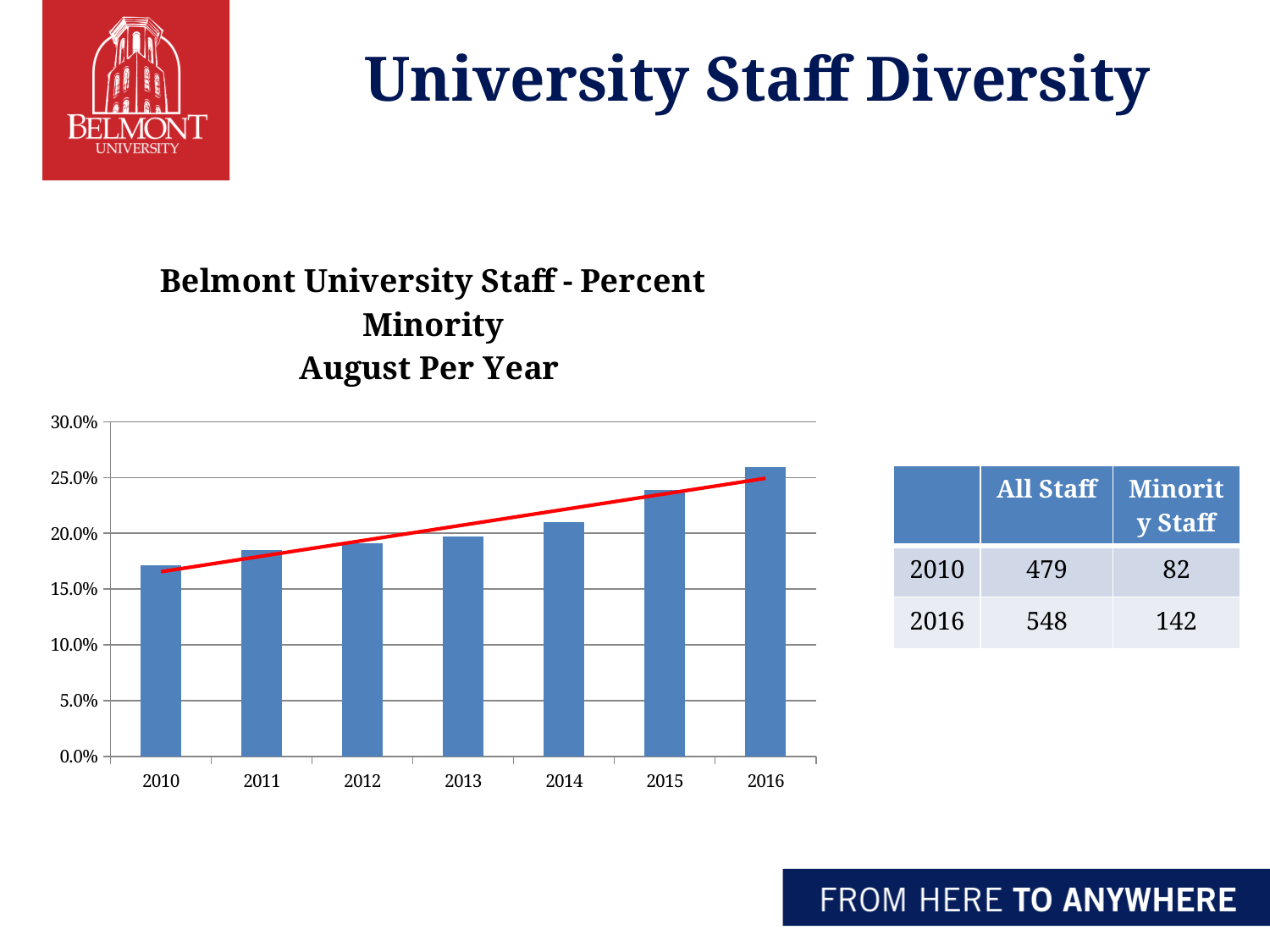
Is the value for 2016 greater or less than 25.0%? greater What kind of chart is shown on the slide? bar chart Is the value for 2011 greater or less than 20.0%? less Which year has a higher percent minority staff, 2010 or 2016? 2016 Is the value for 2010 greater or less than 15.0%? greater What is the title of the chart? Belmont University Staff - Percent Minority August Per Year How many years are plotted on the x axis of the chart? 7 Do the percent minority values rise or fall from 2010 to 2016? rise Which year has the lowest percent minority staff? 2010 Which year has the highest percent minority staff? 2016